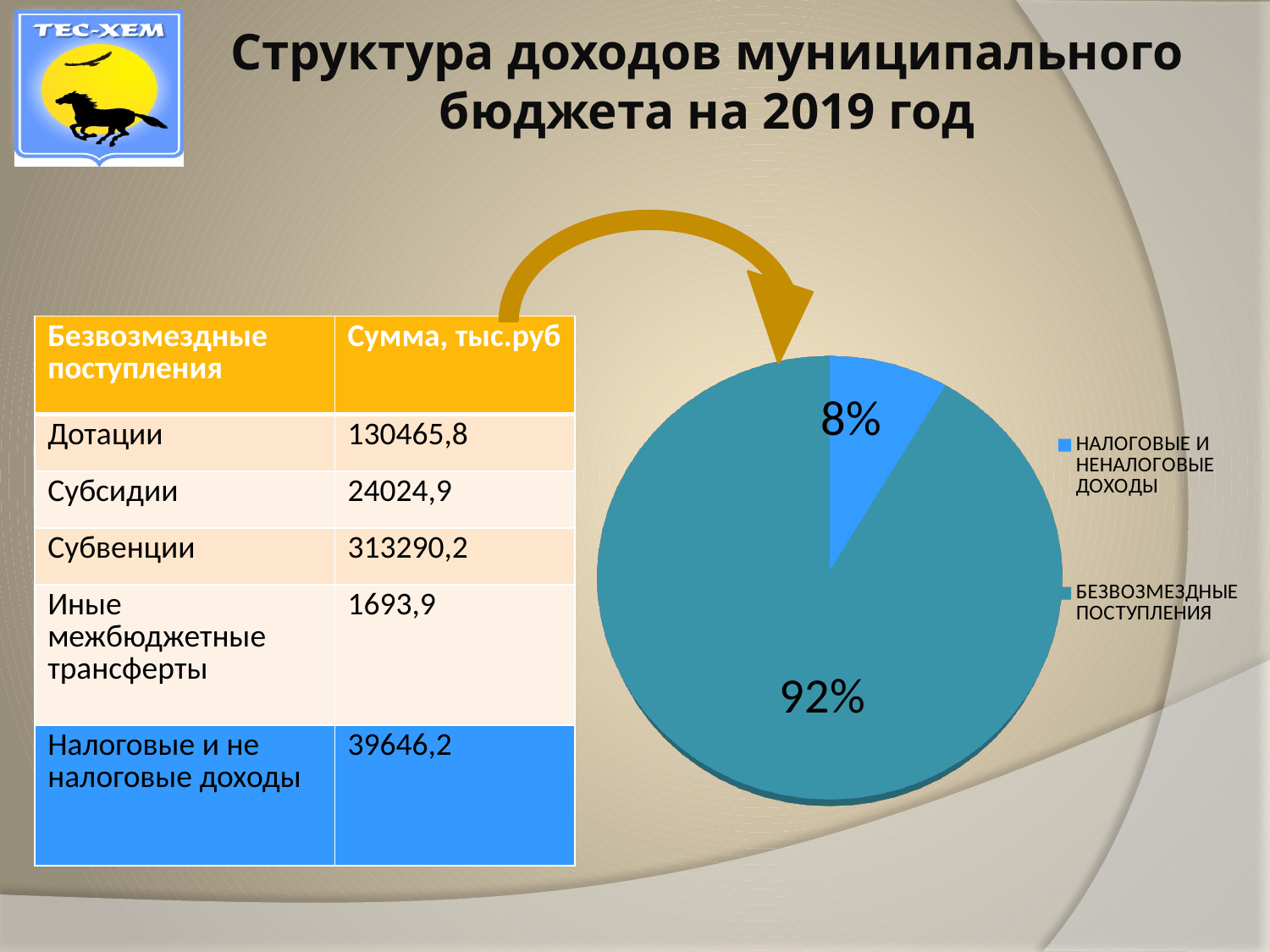
What share of the pie does НАЛОГОВЫЕ И НЕНАЛОГОВЫЕ ДОХОДЫ take? 8% How many entries does the legend of the pie chart list? 2 What kind of chart is shown on the slide? pie chart What is the title of the slide containing the pie chart? Структура доходов муниципального бюджета на 2019 год What colour is the НАЛОГОВЫЕ И НЕНАЛОГОВЫЕ ДОХОДЫ slice in the pie chart? light blue How many slices does the pie chart have? 2 Which slice of the pie chart is the largest? БЕЗВОЗМЕЗДНЫЕ ПОСТУПЛЕНИЯ What is the difference in percentage points between the БЕЗВОЗМЕЗДНЫЕ ПОСТУПЛЕНИЯ slice and the НАЛОГОВЫЕ И НЕНАЛОГОВЫЕ ДОХОДЫ slice? 84 percentage points Which is larger in the pie chart: НАЛОГОВЫЕ И НЕНАЛОГОВЫЕ ДОХОДЫ or БЕЗВОЗМЕЗДНЫЕ ПОСТУПЛЕНИЯ? БЕЗВОЗМЕЗДНЫЕ ПОСТУПЛЕНИЯ Which slice of the pie chart is the smallest? НАЛОГОВЫЕ И НЕНАЛОГОВЫЕ ДОХОДЫ What share of the pie does БЕЗВОЗМЕЗДНЫЕ ПОСТУПЛЕНИЯ take? 92%